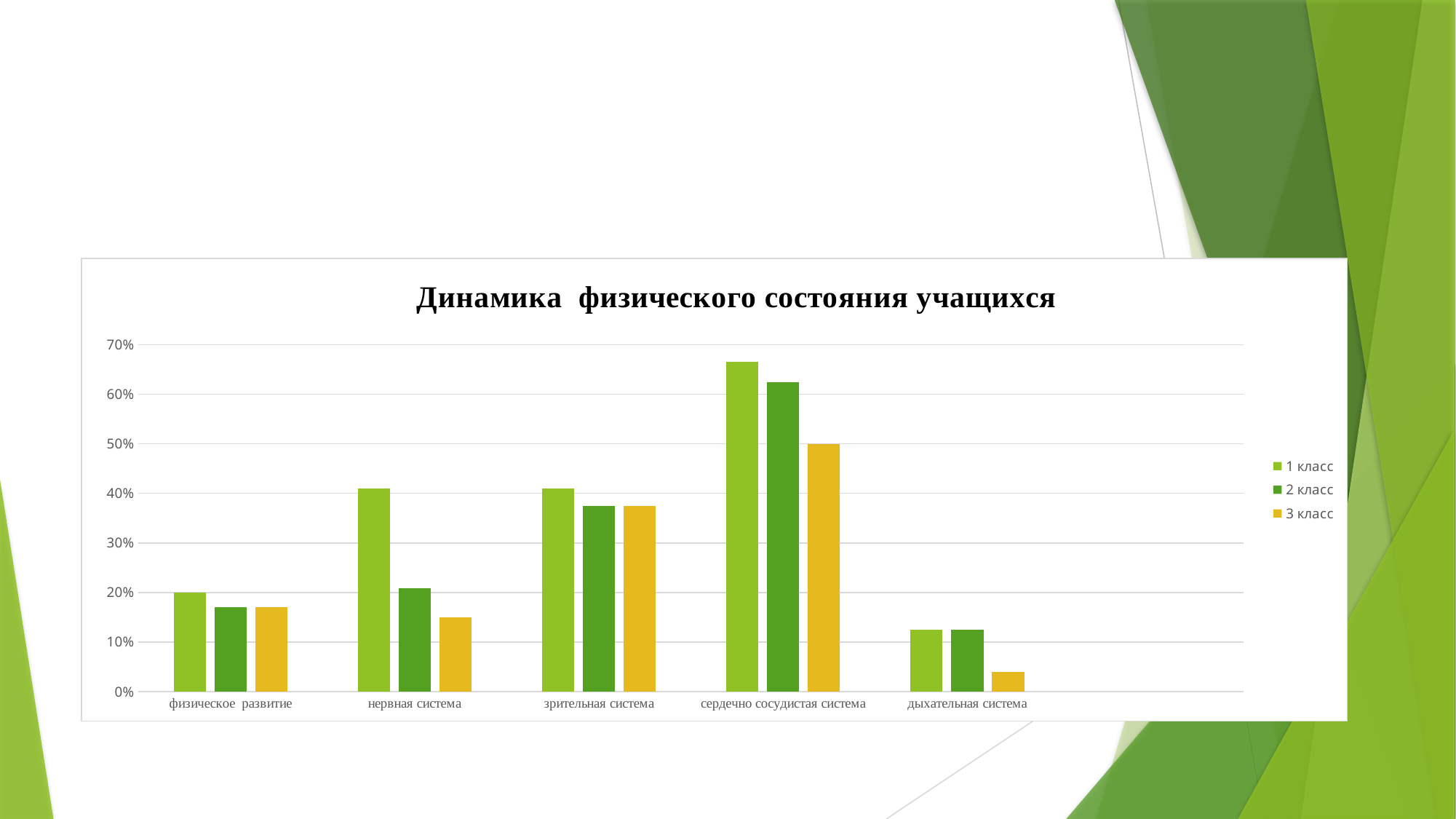
Is the value for 3 класс in нервная система greater or less than 20%? less How many categories are shown on the x axis? 5 How many series does the legend list? 3 Which category has the highest value for 1 класс? сердечно сосудистая система What type of chart is shown on the slide? bar chart Which is larger for 1 класс: нервная система or физическое развитие? нервная система Which category has the lowest value for 3 класс? дыхательная система Is the value for 2 класс in зрительная система greater or less than 40%? less For сердечно сосудистая система, do the values rise or fall from 1 класс to 3 класс? fall Is the value for 3 класс in дыхательная система greater or less than 10%? less What is the title of the chart? Динамика физического состояния учащихся